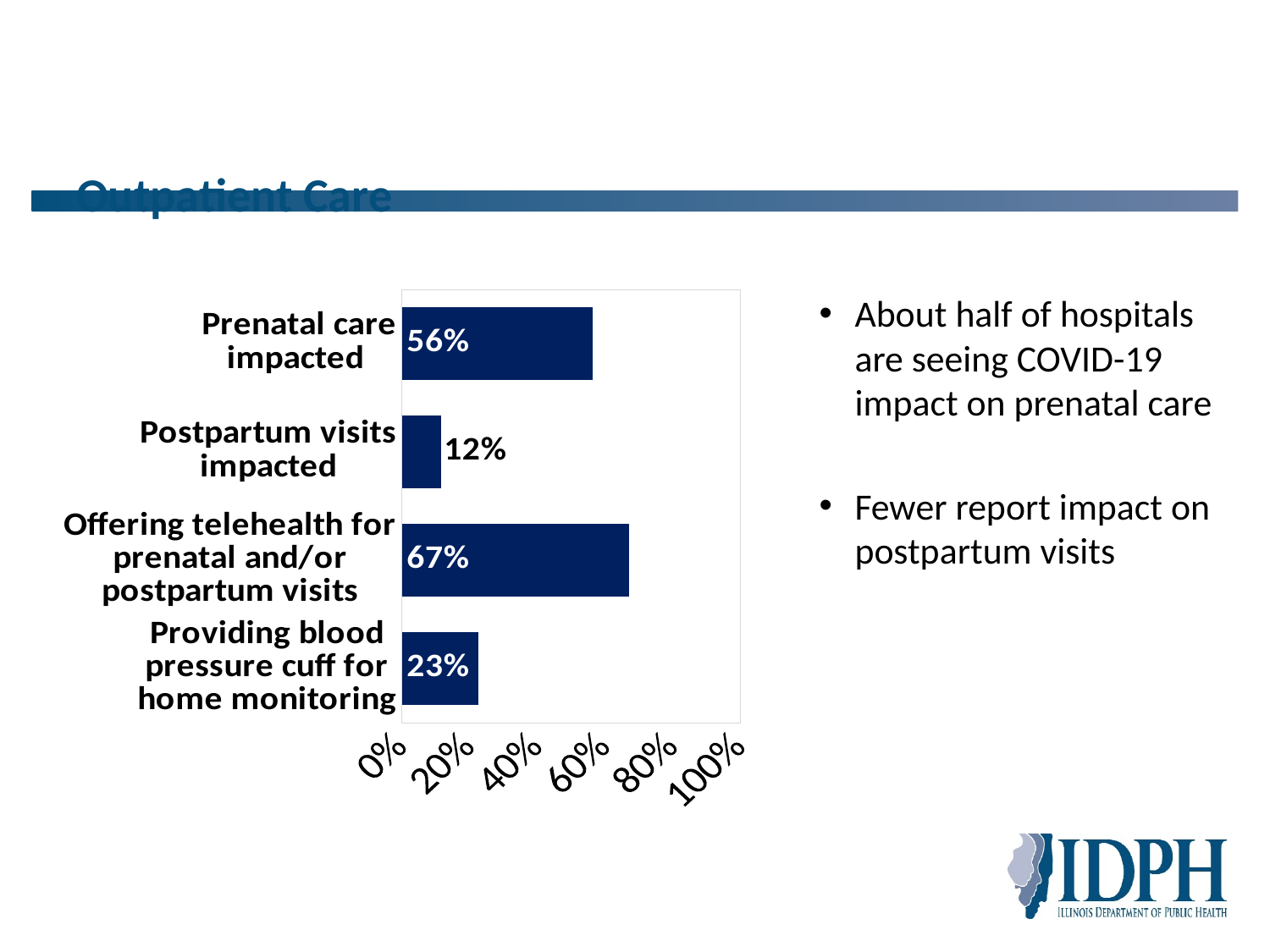
Is the value for 'Offering telehealth for prenatal and/or postpartum visits' greater or less than 60%? greater What is the value for 'Providing blood pressure cuff for home monitoring'? 23% What is the difference between the values for 'Prenatal care impacted' and 'Postpartum visits impacted'? 44% What percentage is shown for 'Offering telehealth for prenatal and/or postpartum visits'? 67% Which category has the lowest value? Postpartum visits impacted Which is larger: the value for 'Prenatal care impacted' or 'Providing blood pressure cuff for home monitoring'? Prenatal care impacted What is the value for 'Postpartum visits impacted'? 12% What kind of chart is shown on the slide? bar chart What is the maximum value shown on the x axis? 100% Which category has the highest value? Offering telehealth for prenatal and/or postpartum visits What percentage of hospitals report prenatal care impacted? 56% How many categories are shown in the chart? 4